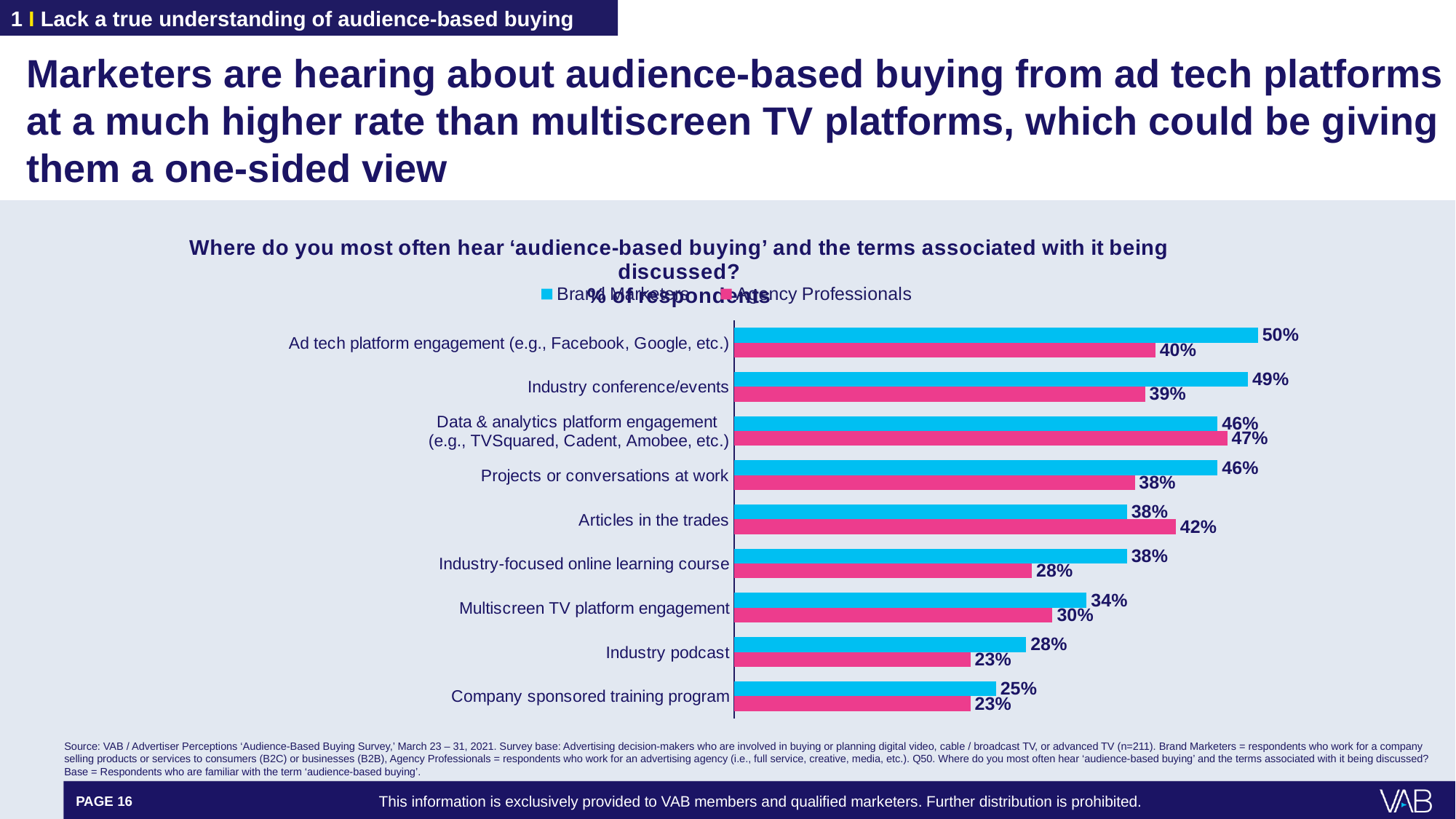
Which category has the highest value for Brand Marketers? Ad tech platform engagement (e.g., Facebook, Google, etc.) How many categories are shown in the chart? 9 What type of chart is shown on the slide? Bar chart What is the difference between the Brand Marketers and Agency Professionals values for 'Industry-focused online learning course'? 10 percentage points What percentage of Agency Professionals most often hear 'audience-based buying' discussed through multiscreen TV platform engagement? 30% For 'Articles in the trades', which group has the larger value, Brand Marketers or Agency Professionals? Agency Professionals Which category has the lowest value for Brand Marketers? Company sponsored training program For 'Industry podcast', which group has the larger value, Brand Marketers or Agency Professionals? Brand Marketers How many series does the chart's legend list? 2 What is the Agency Professionals value for 'Articles in the trades'? 42% What percentage of Brand Marketers most often hear 'audience-based buying' discussed through ad tech platform engagement? 50% Which category has the highest value for Agency Professionals? Data & analytics platform engagement (e.g., TVSquared, Cadent, Amobee, etc.)